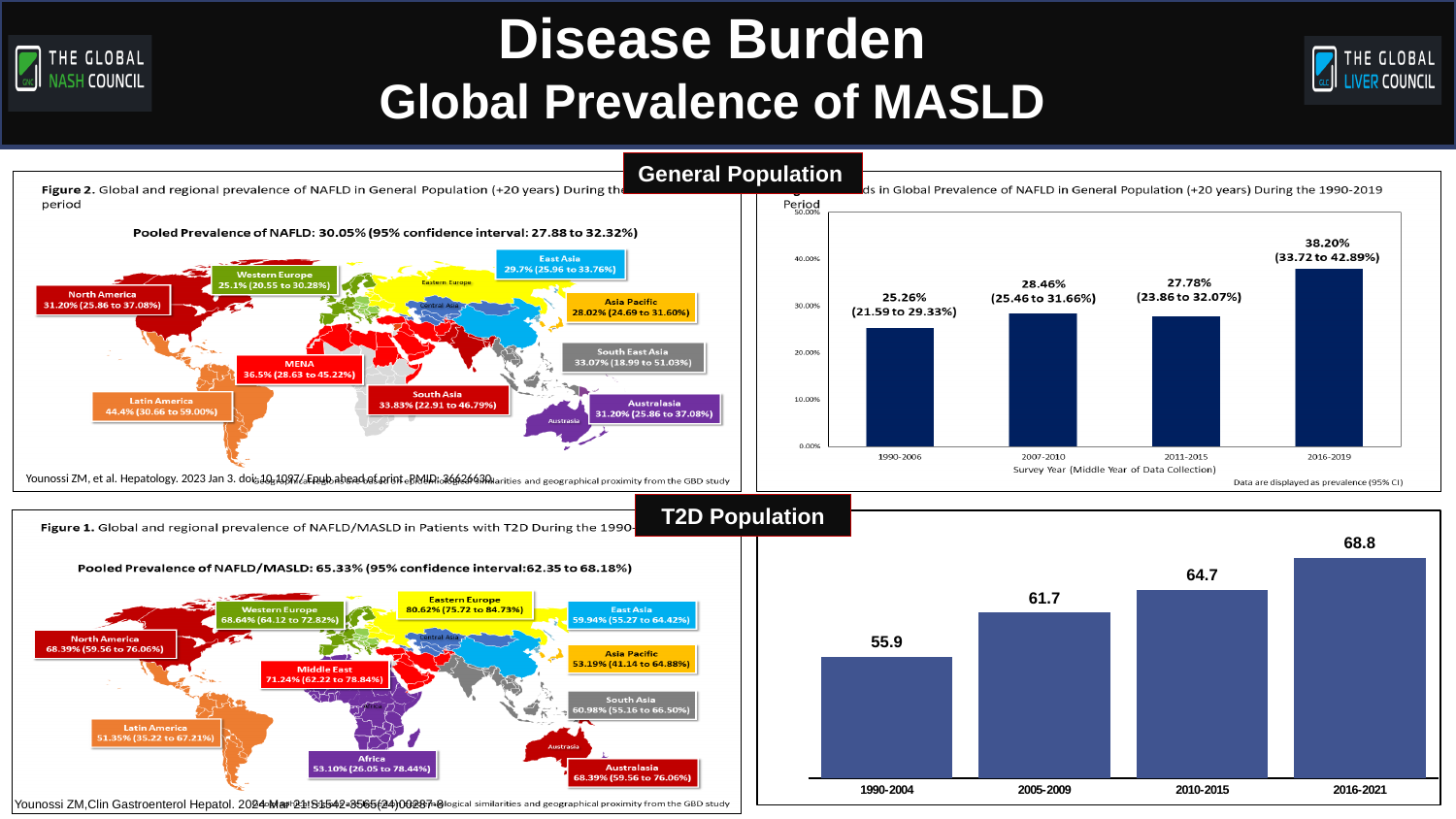
In the General Population bar chart, which survey year period has the highest prevalence? 2016-2019 In the General Population bar chart, which survey year period has the lowest prevalence? 1990-2006 In the T2D Population bar chart, what is the value for 2010-2015? 64.7 In the T2D Population bar chart, what is the value for 1990-2004? 55.9 In the General Population bar chart, what is the prevalence value for 2016-2019? 38.20% What kind of chart is the T2D Population chart on the bottom right? bar chart In the T2D Population bar chart, what is the difference between the values for 2016-2021 and 1990-2004? 12.9 In the T2D Population bar chart, do the values rise or fall from 1990-2004 to 2016-2021? rise In the General Population bar chart, what is the difference between the values for 2016-2019 and 2011-2015? 10.42% In the General Population bar chart, what is the prevalence value for 1990-2006? 25.26% In the General Population bar chart, which is larger, the value for 2007-2010 or the value for 2011-2015? 2007-2010 In the General Population bar chart, how many survey year periods are shown? 4